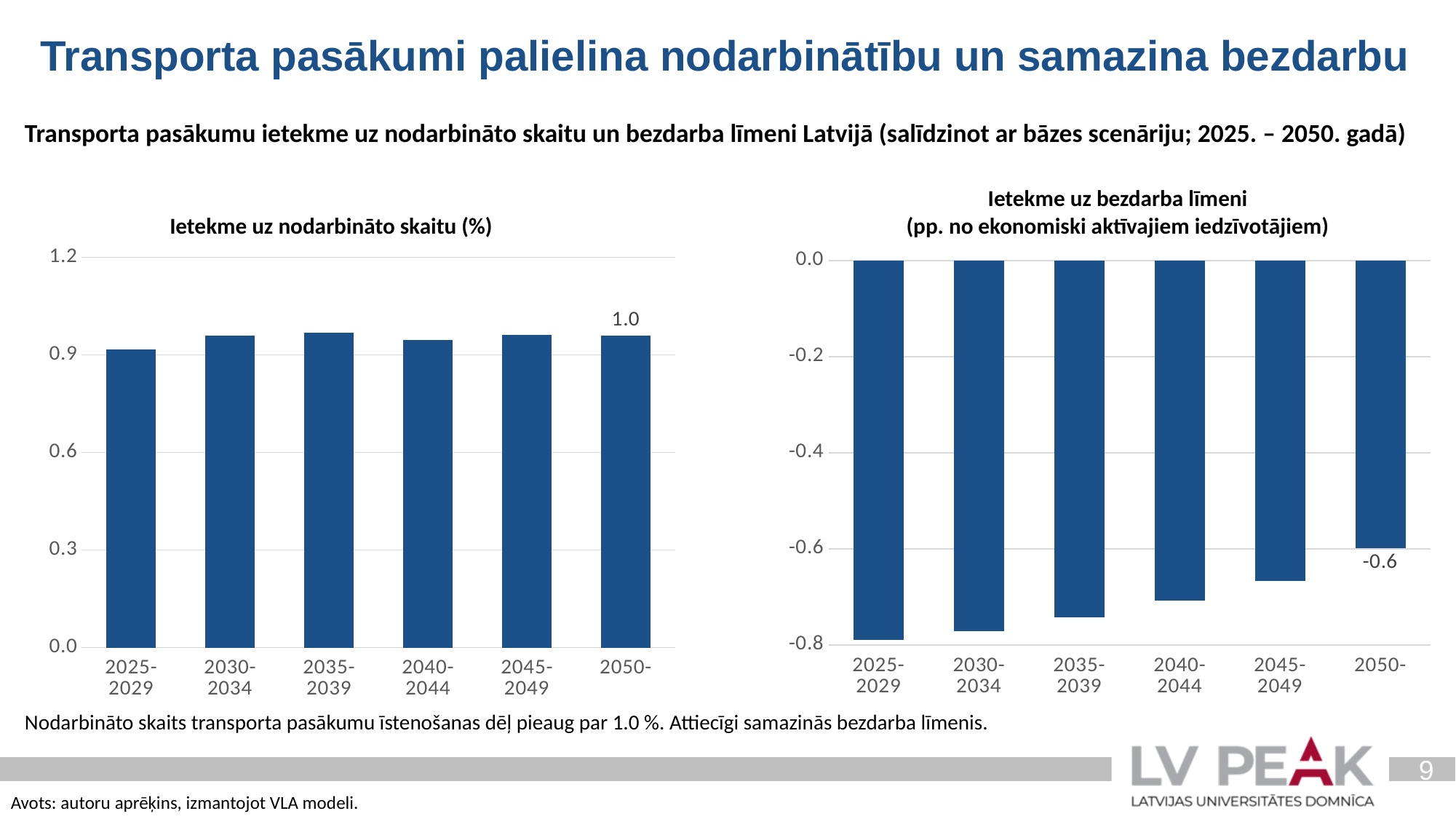
On the left chart, which period has the lowest value? 2025-2029 On the right chart, which period has the highest (least negative) value? 2050- On the right chart, is the value for 2025-2029 greater or less than -0.6? less How many periods are shown on the left chart? 6 What kind of chart is the chart titled 'Ietekme uz bezdarba līmeni'? bar chart On the chart titled 'Ietekme uz bezdarba līmeni', what is the value for 2050-? -0.6 On the right chart, which is larger, the value for 2025-2029 or the value for 2050-? 2050- On the right chart, which period has the lowest (most negative) value? 2025-2029 On the chart titled 'Ietekme uz nodarbināto skaitu (%)', what is the value for 2050-? 1.0 On the left chart, is the value for 2035-2039 greater or less than 0.9? greater What is the title of the left chart? Ietekme uz nodarbināto skaitu (%) On the right chart, do the values rise or fall from 2025-2029 to 2050-? rise